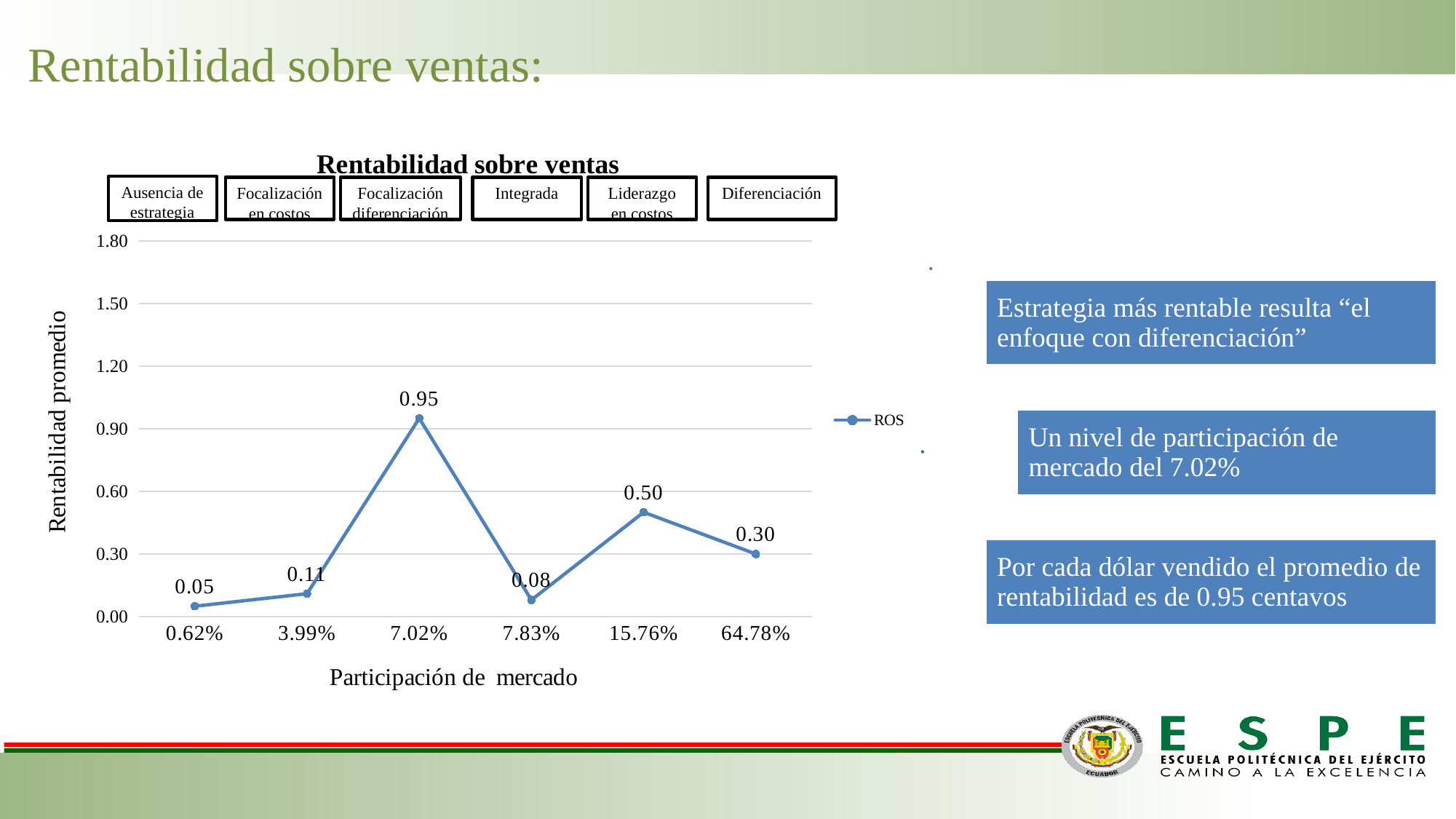
Which market share category has the lowest ROS value? 0.62% Is the ROS value at 15.76% greater or less than 0.60? less What is the difference between the ROS value at 7.02% and the ROS value at 15.76%? 0.45 How many data points are plotted on the chart? 6 What is the ROS value at the 64.78% market share point? 0.30 How many series does the legend list? 1 What is the title of the chart? Rentabilidad sobre ventas What kind of chart is shown on the slide? line chart What is the ROS value at the 7.02% market share point? 0.95 Which is larger, the ROS value at 3.99% or the ROS value at 7.83%? 3.99% Which market share category has the highest ROS value? 7.02% What is the ROS value at the 0.62% market share point? 0.05